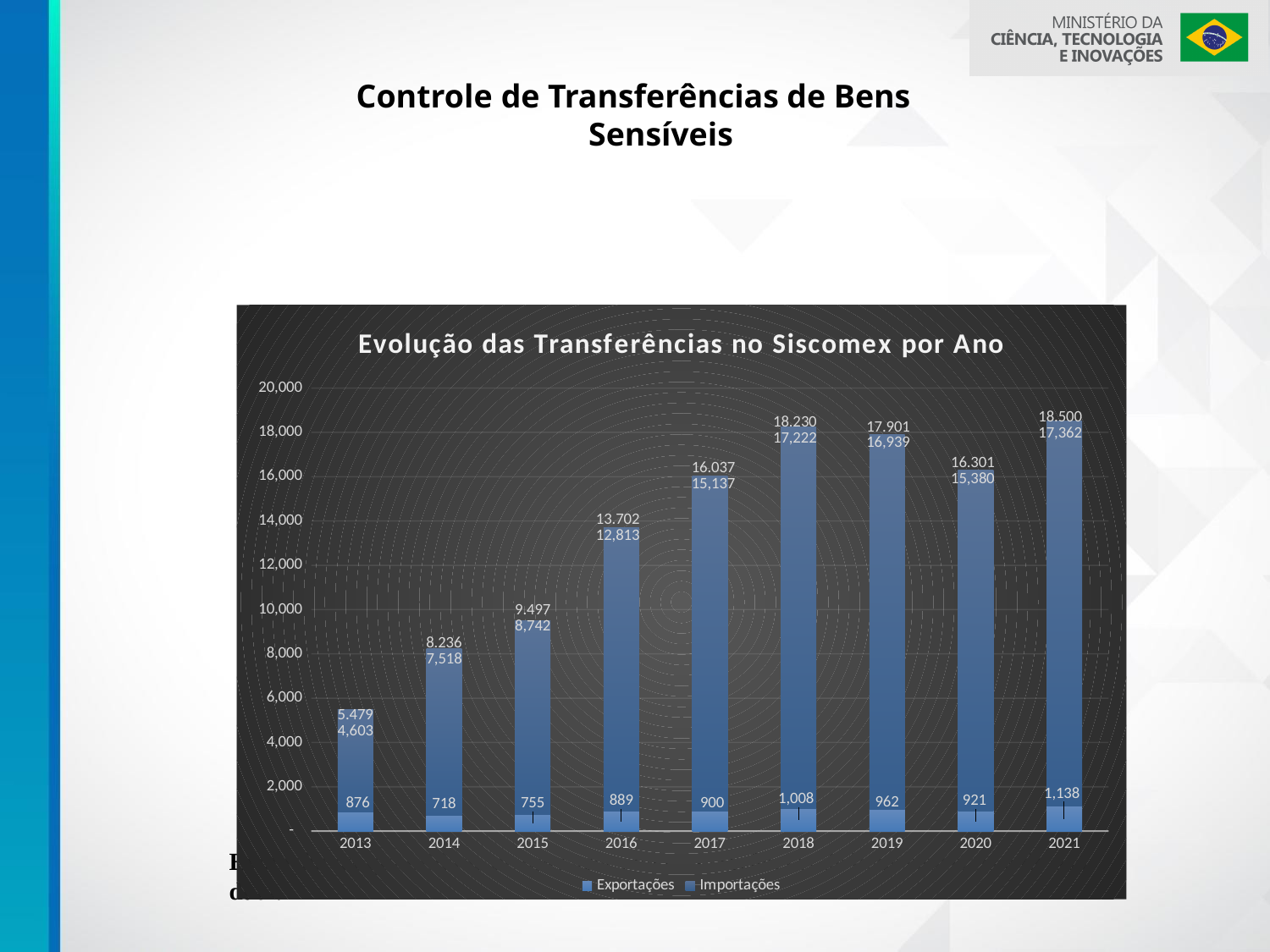
How many years are shown on the x axis? 9 Which year has the highest value for Exportações? 2021 What is the value for Exportações in 2021? 1,138 Do the Importações values rise or fall from 2013 to 2018? Rise What is the value for Importações in 2018? 17,222 What kind of chart is shown? Stacked bar chart Which year has the lowest value for Exportações? 2014 What is the difference between Importações in 2021 and Importações in 2020? 1,982 What is the value for Importações in 2013? 4,603 Which year has the lowest value for Importações? 2013 How many series does the legend list? 2 Which is larger: Importações in 2019 or Importações in 2020? Importações in 2019